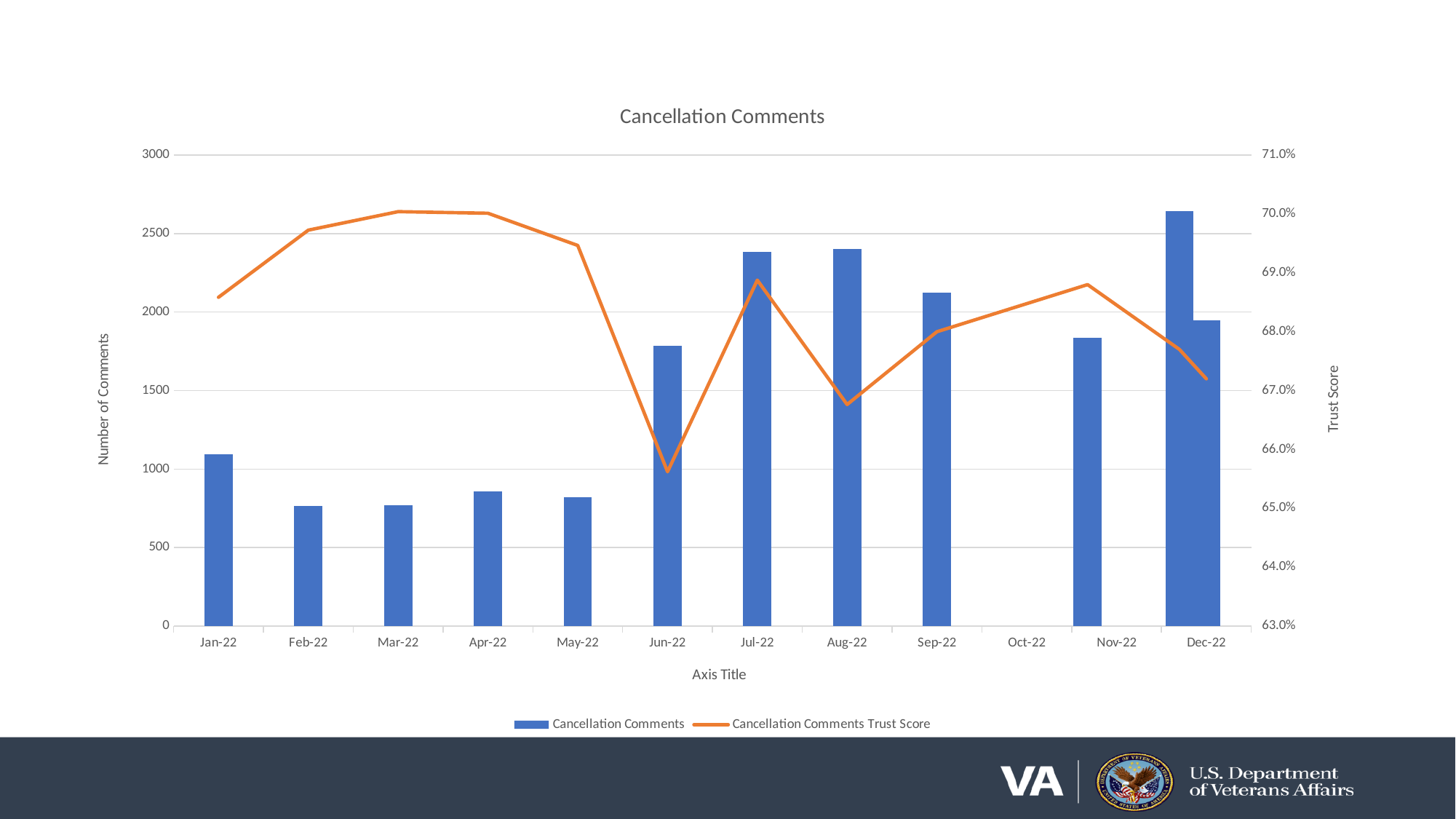
How many months are shown on the x axis? 12 Is the Cancellation Comments Trust Score for Jan-22 greater or less than 68.0%? greater How many series does the legend list? 2 Which month has more Cancellation Comments, Jun-22 or Jul-22? Jul-22 Is the number of Cancellation Comments for Jan-22 greater or less than 1000? greater Is the Cancellation Comments Trust Score for Jun-22 greater or less than 66.0%? less What is the title of the chart? Cancellation Comments What is the title of the left vertical axis? Number of Comments Which month has the lowest Cancellation Comments Trust Score? Jun-22 What kind of chart is this? Combination bar and line chart